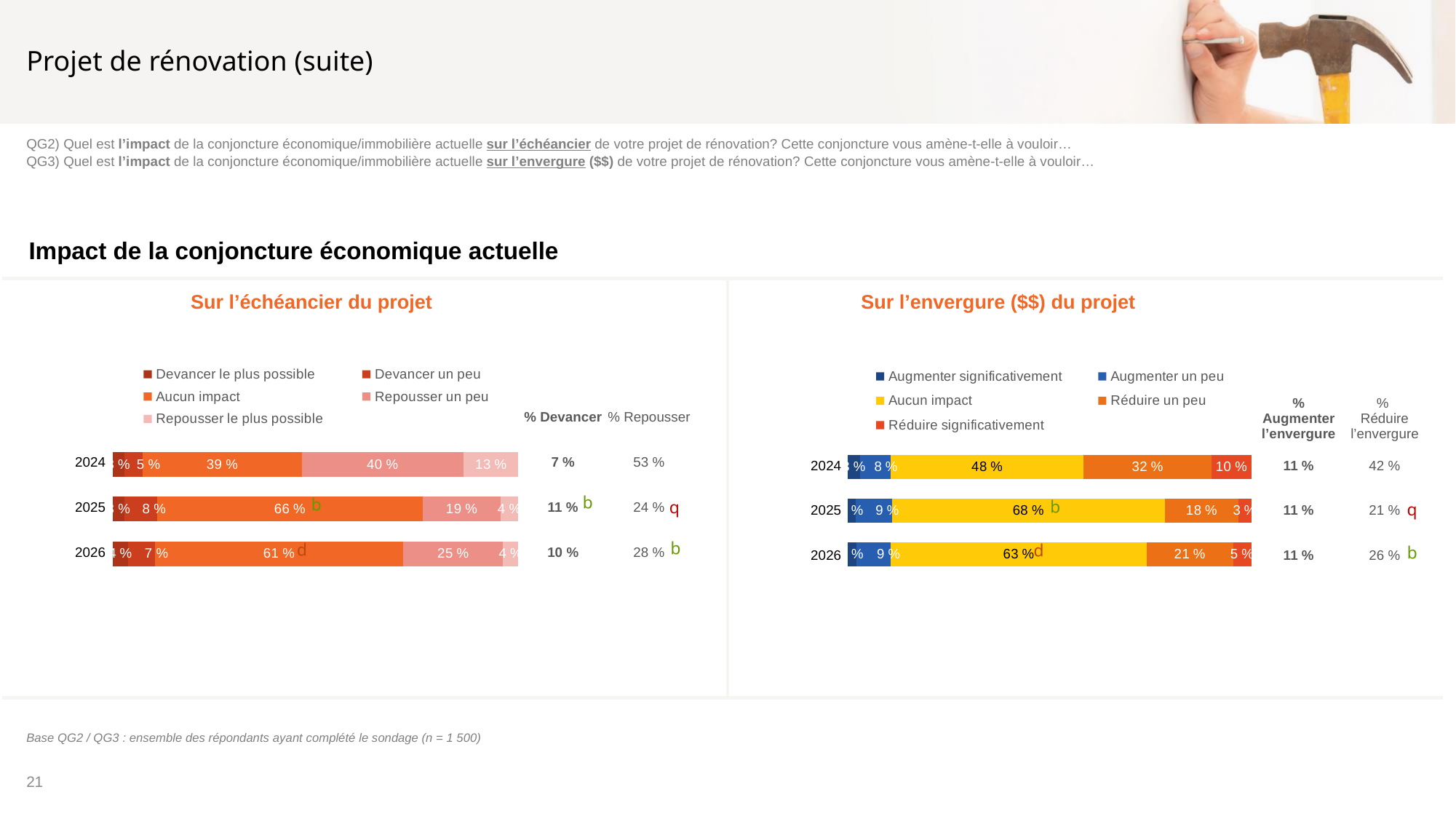
In the chart 'Sur l'envergure ($$) du projet', what is the '% Réduire l'envergure' value for 2025? 21 % In the chart 'Sur l'envergure ($$) du projet', what is the value of 'Aucun impact' for 2026? 63 % In the chart 'Sur l'envergure ($$) du projet', what is the value of 'Réduire un peu' for 2024? 32 % How many series does the legend of the chart 'Sur l'envergure ($$) du projet' list? 5 In the chart 'Sur l'échéancier du projet', what is the value of 'Repousser un peu' for 2024? 40 % In the chart 'Sur l'échéancier du projet', what is the value of 'Aucun impact' for 2025? 66 % In the chart 'Sur l'échéancier du projet', what is the difference between the 'Repousser un peu' values for 2024 and 2026? 15 % In the chart 'Sur l'envergure ($$) du projet', which year has the lowest 'Réduire significativement' value? 2025 How many years are shown in the chart 'Sur l'échéancier du projet'? 3 In the chart 'Sur l'échéancier du projet', which year has the highest 'Aucun impact' value? 2025 In the chart 'Sur l'envergure ($$) du projet', is the 'Aucun impact' value larger for 2024 or for 2025? 2025 What kind of chart is 'Sur l'échéancier du projet'? Stacked bar chart